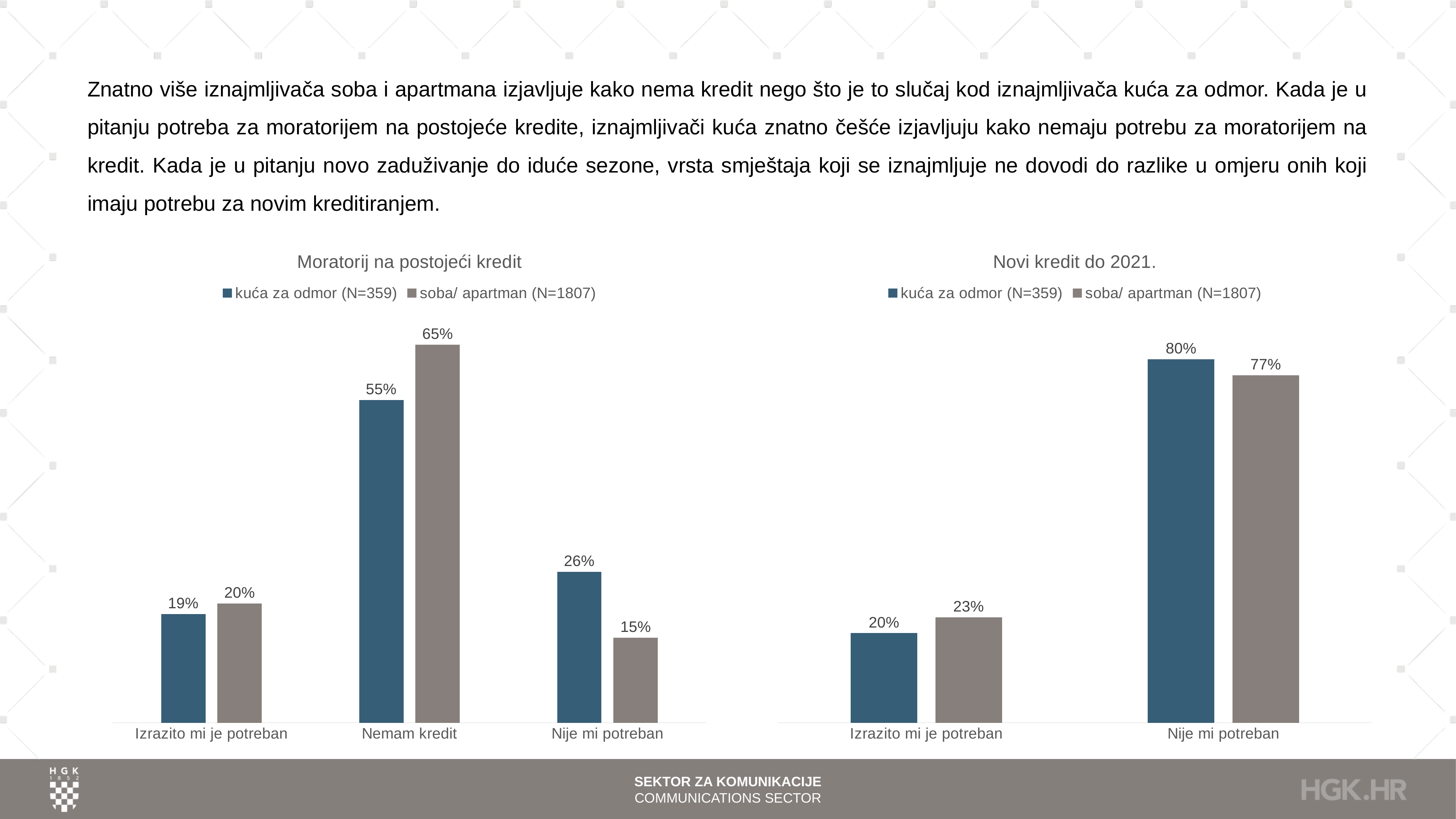
In the 'Moratorij na postojeći kredit' chart, what is the value for 'kuća za odmor (N=359)' in the 'Nemam kredit' category? 55% In the 'Novi kredit do 2021.' chart, what is the difference between the 'kuća za odmor (N=359)' and 'soba/ apartman (N=1807)' values for 'Nije mi potreban'? 3% In the 'Moratorij na postojeći kredit' chart, which category has the lowest value for 'kuća za odmor (N=359)'? Izrazito mi je potreban In the 'Novi kredit do 2021.' chart, what is the value for 'kuća za odmor (N=359)' in the 'Nije mi potreban' category? 80% How many categories are shown on the x axis of the 'Novi kredit do 2021.' chart? 2 How many series does the legend of the 'Moratorij na postojeći kredit' chart list? 2 In the 'Moratorij na postojeći kredit' chart, which category has the highest value for 'soba/ apartman (N=1807)'? Nemam kredit In the 'Moratorij na postojeći kredit' chart, what is the difference between the 'soba/ apartman (N=1807)' and 'kuća za odmor (N=359)' values for 'Nemam kredit'? 10% In the 'Novi kredit do 2021.' chart, what is the value for 'soba/ apartman (N=1807)' in the 'Izrazito mi je potreban' category? 23% In the 'Moratorij na postojeći kredit' chart, which series has the larger value for 'Nije mi potreban'? kuća za odmor (N=359) In the 'Moratorij na postojeći kredit' chart, what is the value for 'soba/ apartman (N=1807)' in the 'Nije mi potreban' category? 15% What kind of chart is the 'Novi kredit do 2021.' chart? Bar chart